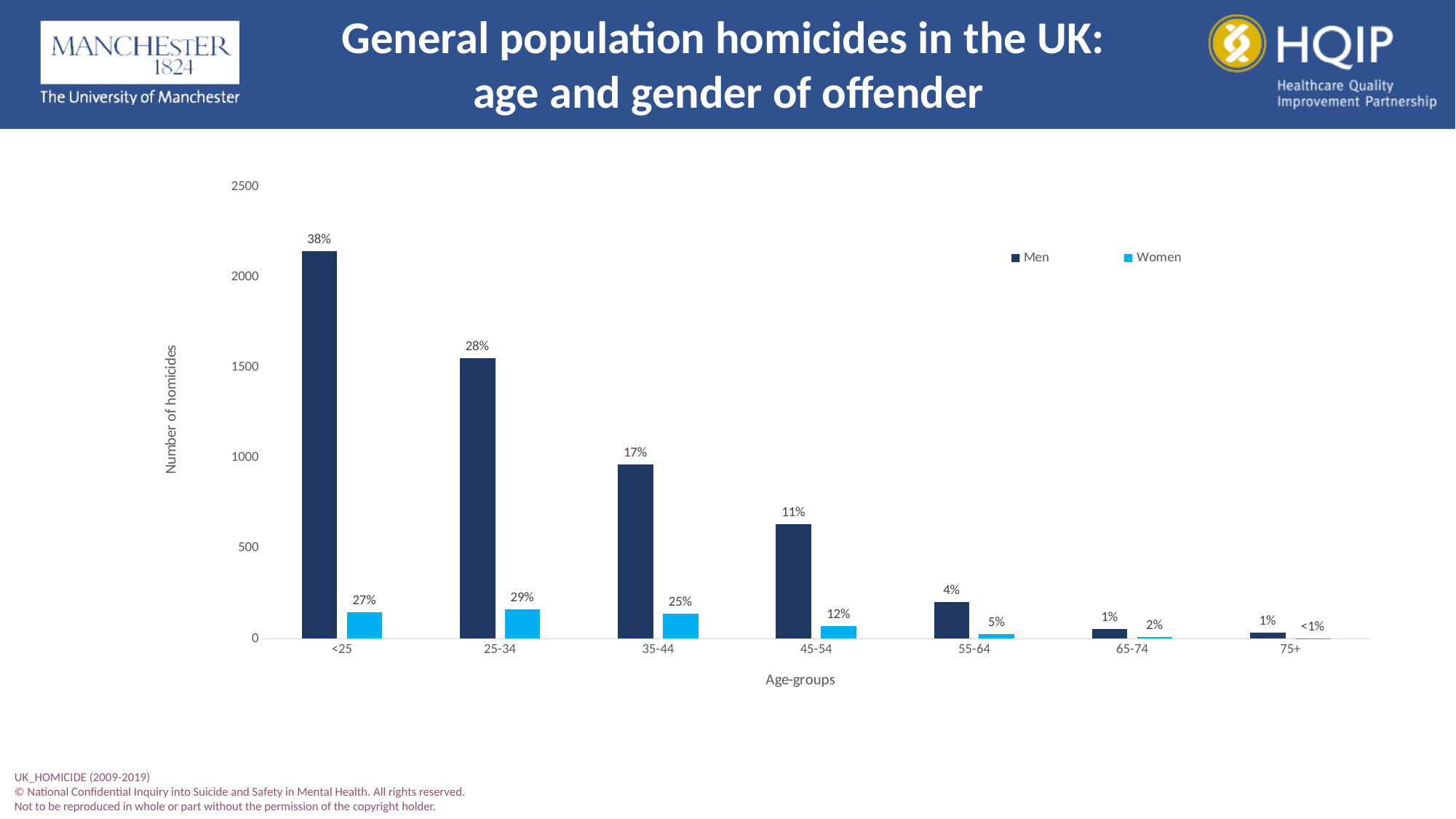
Do the Men values rise or fall as the age groups increase along the x axis? fall What kind of chart is shown on the slide? bar chart What percentage label is shown on the Women bar for the 75+ age group? <1% How many series does the legend list? 2 Is the number of homicides for Men in the 35-44 age group greater or less than 1000? less Which age group has the lowest number of homicides for Women? 75+ How many age-group categories are shown on the x axis? 7 Is the number of homicides for Men in the <25 age group greater or less than 2000? greater What percentage label is shown on the Women bar for the 25-34 age group? 29% Which age group has the highest number of homicides for Men? <25 What percentage label is shown on the Men bar for the <25 age group? 38% What percentage label is shown on the Men bar for the 45-54 age group? 11%